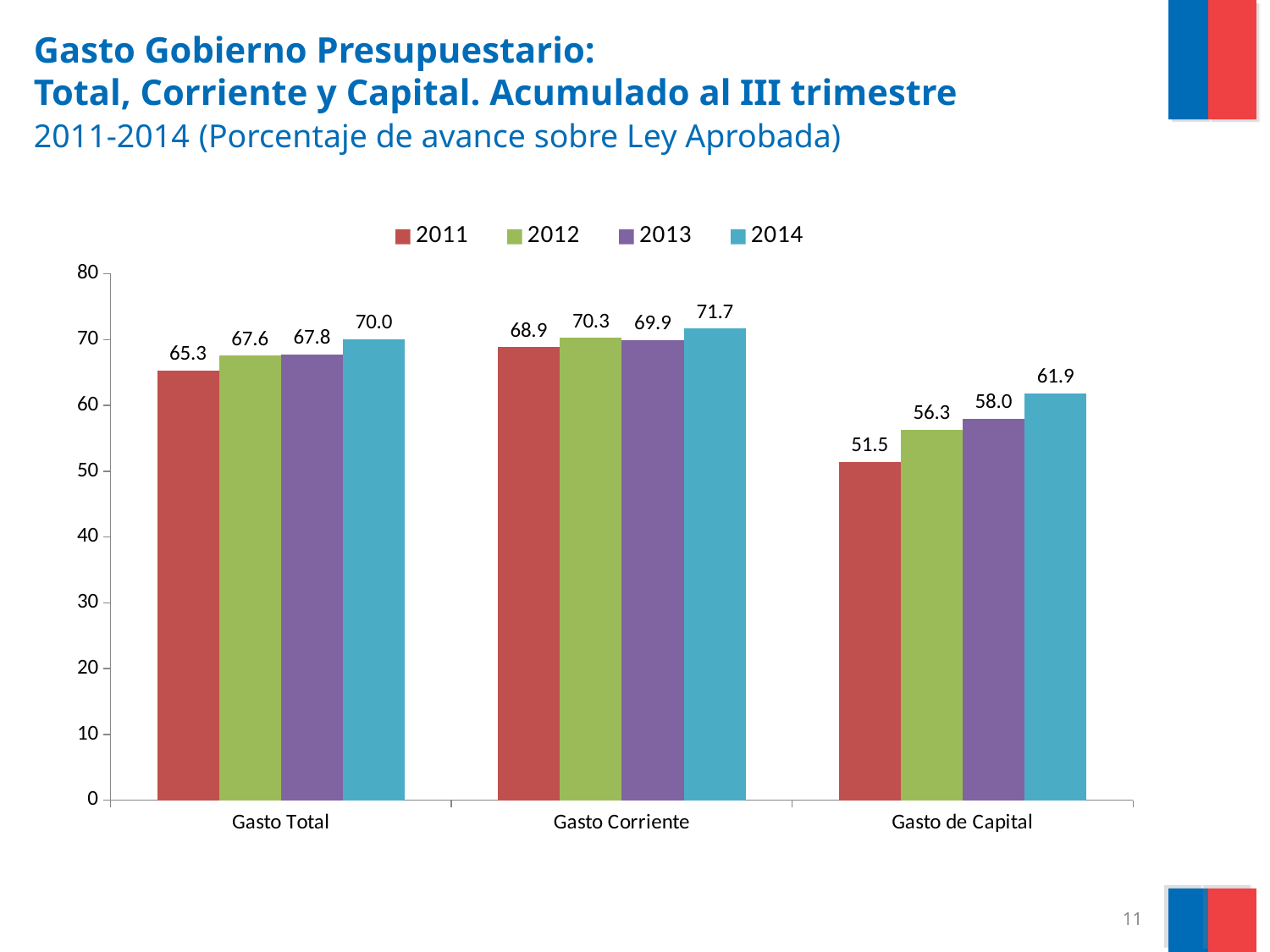
What is the value for Gasto Total in 2014? 70.0 Do the values for Gasto de Capital rise or fall from 2011 to 2014? rise Which year has the highest value for Gasto Corriente? 2014 Which is larger: Gasto Total in 2012 or Gasto de Capital in 2014? Gasto Total in 2012 Which category has the lowest value in 2013? Gasto de Capital What is the value for Gasto de Capital in 2011? 51.5 Is the value for Gasto de Capital in 2012 greater or less than 60? less How many categories are shown on the x axis? 3 What kind of chart is shown on the slide? bar chart How many series does the legend list? 4 What is the difference between the 2014 and 2011 values for Gasto de Capital? 10.4 What is the value for Gasto Corriente in 2012? 70.3